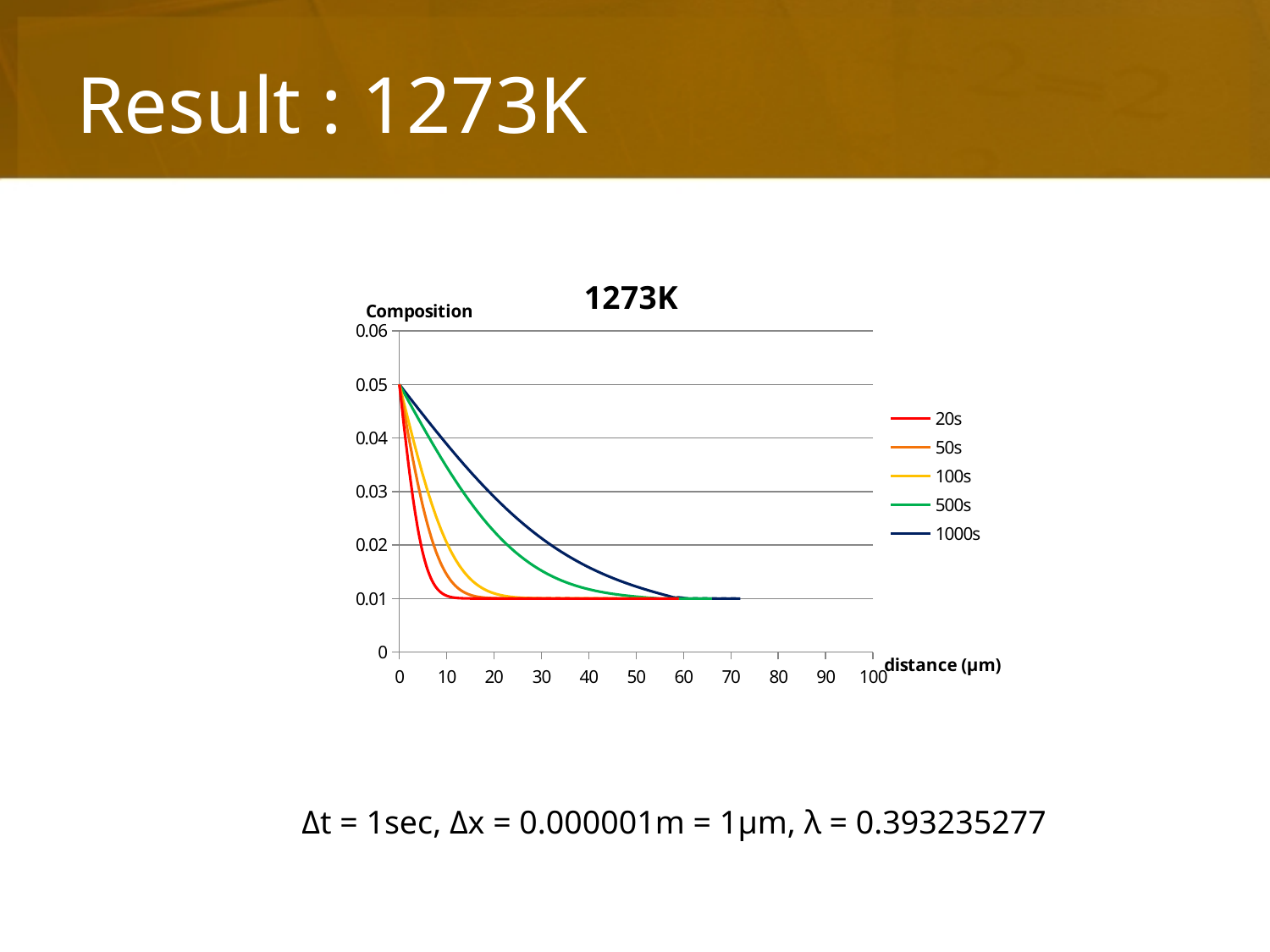
At a distance of 20 μm, which series has the higher composition, 1000s or 20s? 1000s What is the label of the x axis of the chart? distance (μm) What composition value do the curves level off at for large distances? 0.01 Is the composition for the 20s series at a distance of 10 μm greater or less than 0.02? less Do the composition values rise or fall as distance increases along the x axis? fall Which series reaches the 0.01 plateau at the shortest distance? 20s What is the title of the chart? 1273K What kind of chart is shown on the slide? line chart Is the composition for the 100s series at a distance of 20 μm greater or less than 0.02? less What composition value do all the curves start at when the distance is 0? 0.05 How many series does the legend of the 1273K chart list? 5